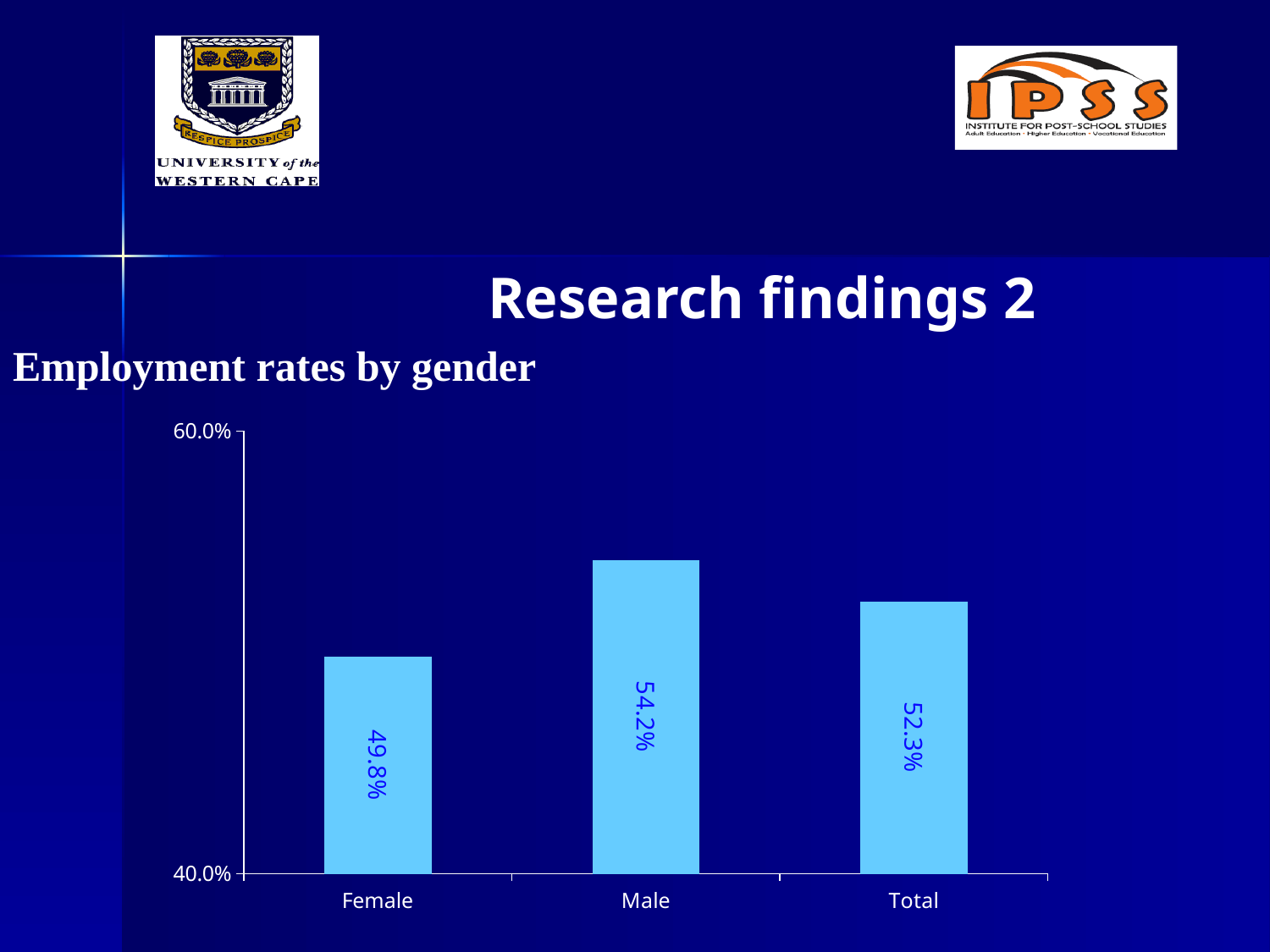
What kind of chart is shown on the slide? bar chart Which category has the lowest employment rate? Female What is the title of the chart? Employment rates by gender What is the employment rate for Male? 54.2% Is the employment rate for Female greater or less than 50.0%? less Which is larger, the employment rate for Total or for Female? Total Which category has the highest employment rate? Male What is the difference between the Male and Female employment rates? 4.4% How many categories are shown on the x axis? 3 What is the employment rate for Total? 52.3% What is the employment rate for Female? 49.8% What is the maximum value shown on the y axis? 60.0%